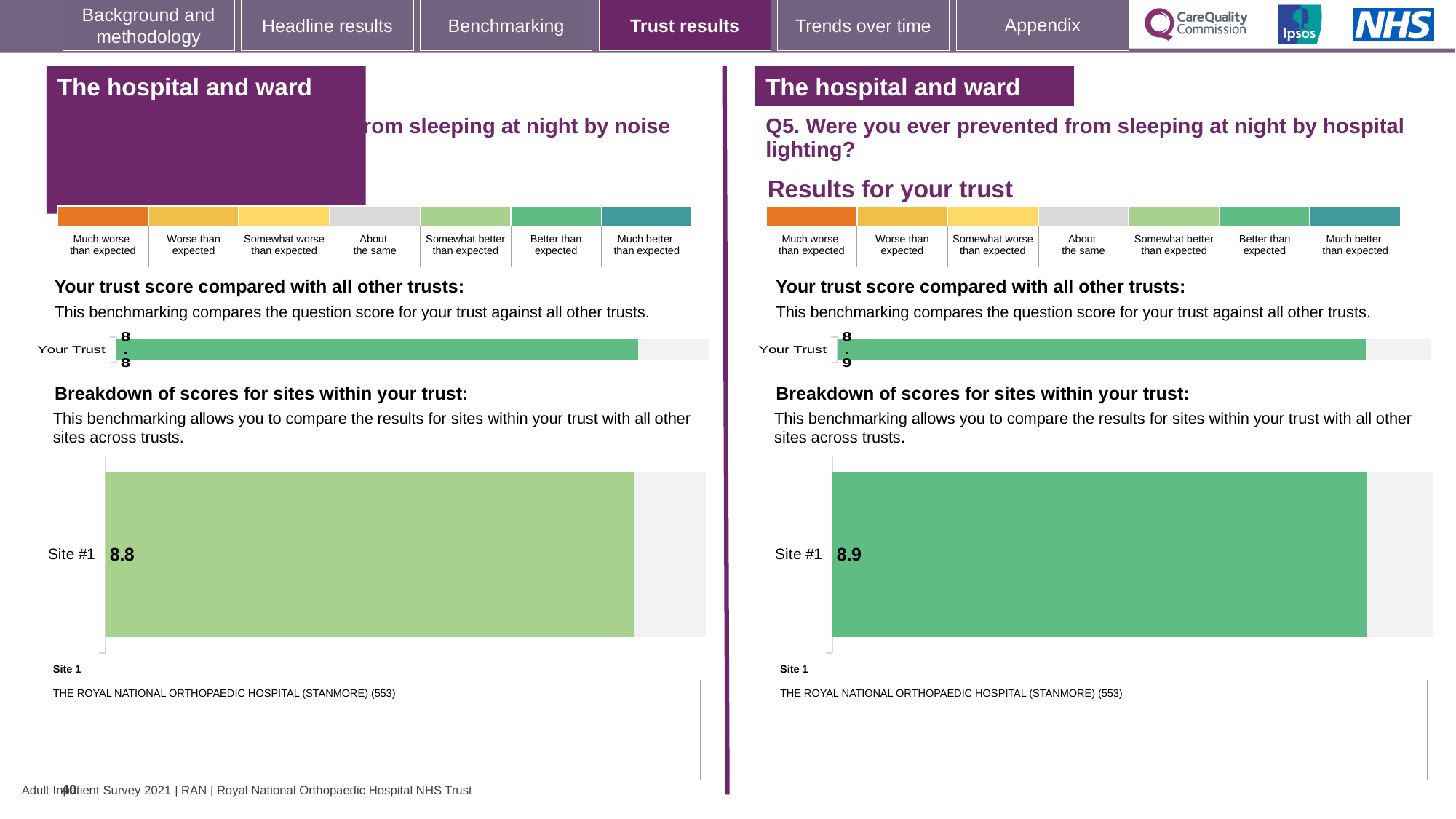
Which is larger: the Site #1 score on the left-hand chart (noise) or the Site #1 score on the right-hand chart (Q5, lighting)? Right-hand chart (Q5, lighting), 8.9 According to the colour key, which benchmark category does the green colour of the Site #1 bar on the right-hand chart (Q5, hospital lighting) represent? Better than expected Which site name is listed as Site 1 beneath the right-hand site breakdown chart (Q5, hospital lighting)? THE ROYAL NATIONAL ORTHOPAEDIC HOSPITAL (STANMORE) (553) How many sites are shown in the site breakdown chart on the right-hand side (Q5, hospital lighting)? 1 What type of chart is used to show the Your Trust score on the left-hand side (sleeping at night by noise)? Bar chart What type of chart is used to show the Site #1 score on the right-hand side (Q5, hospital lighting)? Bar chart On the right-hand site breakdown chart for Q5 (hospital lighting), what is the score for Site #1? 8.9 How many sites are shown in the site breakdown chart on the left-hand side (sleeping at night by noise)? 1 On the left-hand chart about being prevented from sleeping at night by noise, what is the score shown for Your Trust? 8.8 What is the difference between the Your Trust score on the right-hand chart (Q5, lighting) and the Your Trust score on the left-hand chart (noise)? 0.1 On the right-hand chart for Q5 (hospital lighting), what is the score shown for Your Trust? 8.9 On the left-hand site breakdown chart (sleeping at night by noise), what is the score for Site #1? 8.8